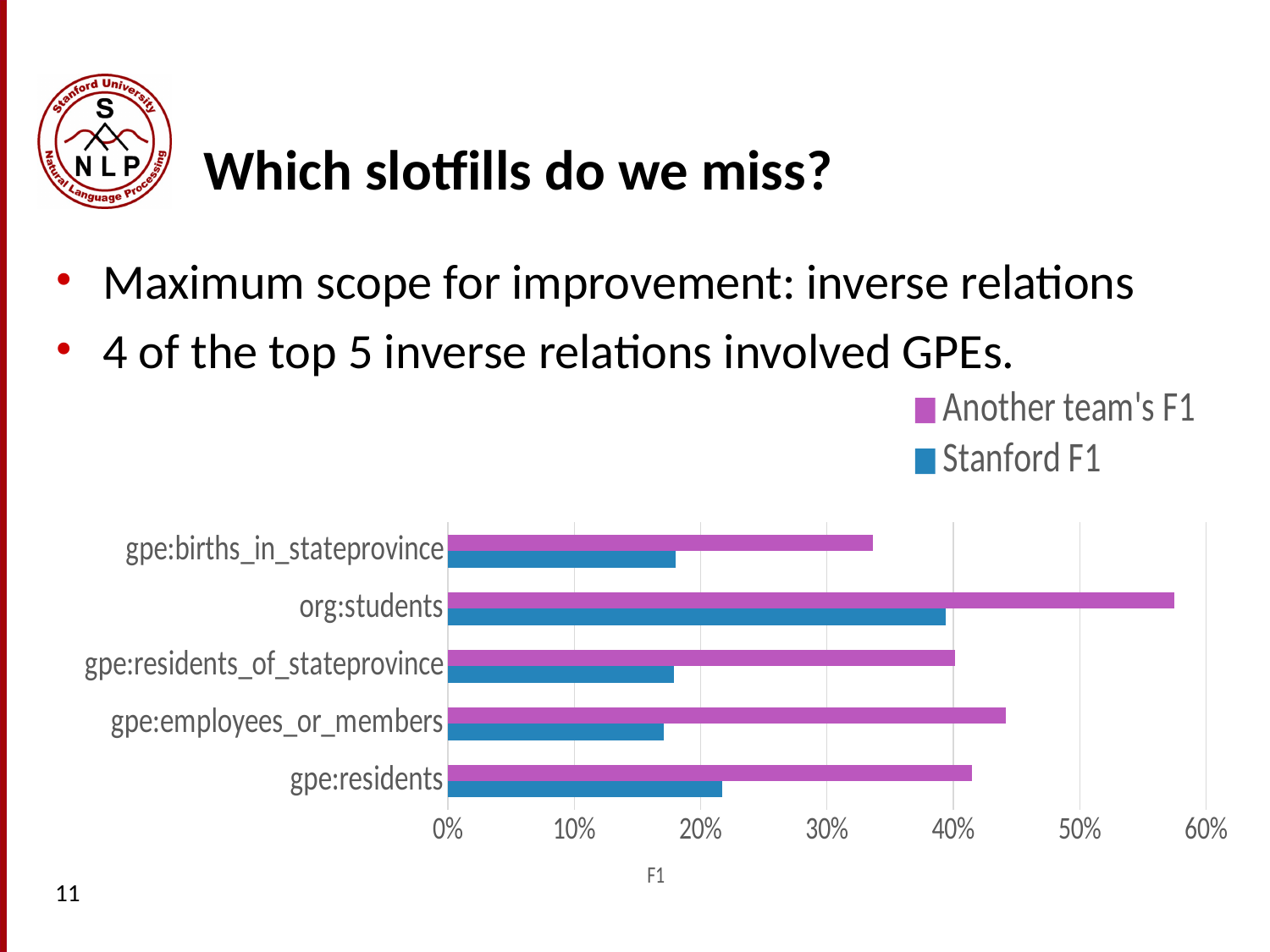
Is the value of Another team's F1 for gpe:births_in_stateprovince greater or less than 30%? greater What kind of chart is shown on the slide? bar chart Is the value of Another team's F1 for org:students greater or less than 50%? greater Which category has the lowest value for Another team's F1? gpe:births_in_stateprovince What is the label on the chart's horizontal axis? F1 How many categories (slot types) are shown on the chart? 5 For gpe:residents, which series has the larger value, Another team's F1 or Stanford F1? Another team's F1 Which is larger: Stanford F1 for org:students or Stanford F1 for gpe:residents? Stanford F1 for org:students Which category has the highest value for Another team's F1? org:students How many series does the chart's legend list? 2 Is the value of Stanford F1 for gpe:employees_or_members greater or less than 20%? less Which category has the highest value for Stanford F1? org:students